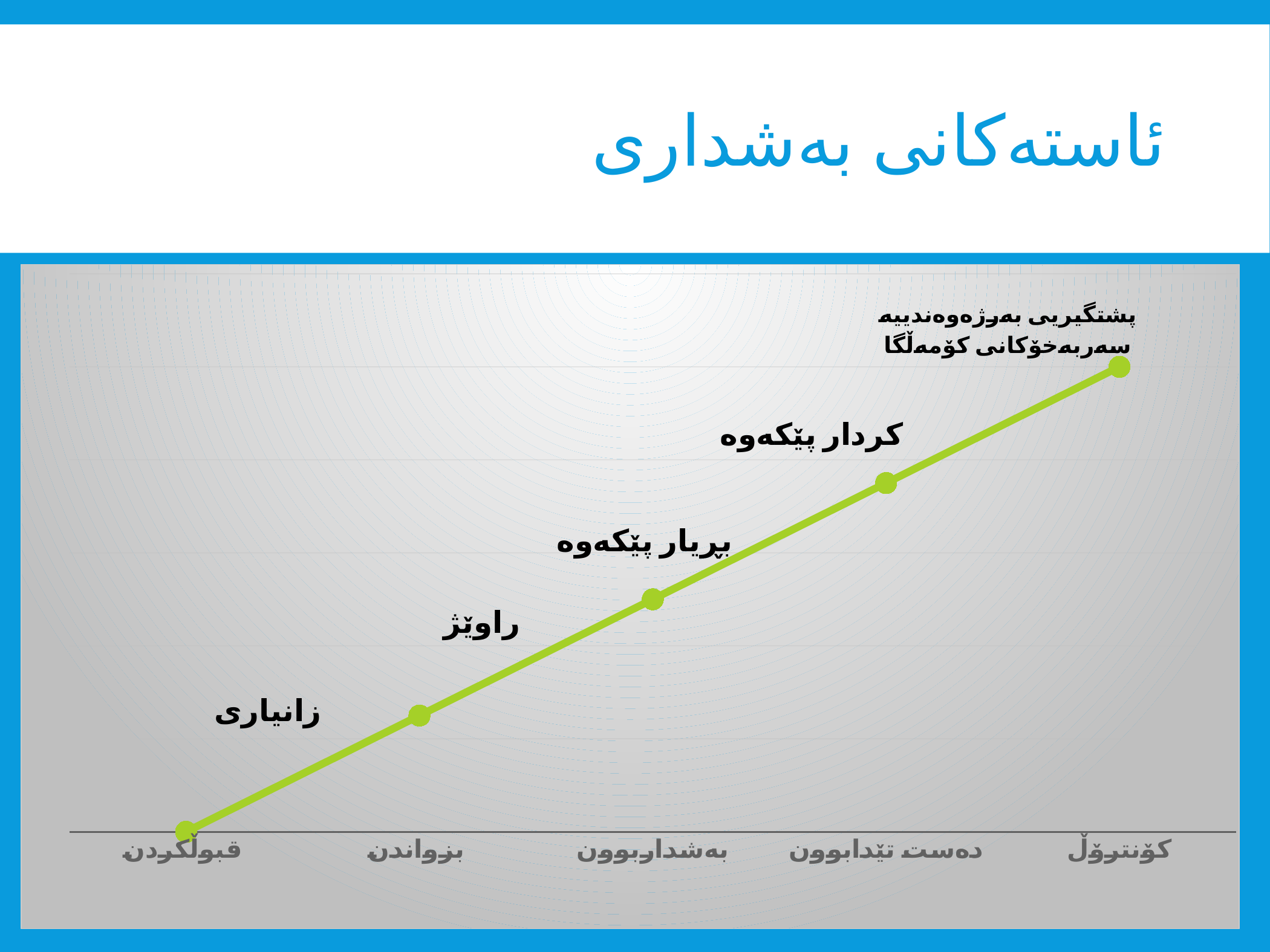
Which is higher on the line, بزواندن or دەست تێدابوون? دەست تێدابوون What colour is the plotted line? green Which category is in the middle of the x axis? بەشداربوون Which category has the highest point on the line? کۆنترۆڵ How many categories are shown on the x axis? 5 Which is lower on the line, بەشداربوون or قبوڵکردن? قبوڵکردن What is the title of the slide above the chart? ئاستەکانی بەشداری What kind of chart is shown on the slide? line chart Do the values rise or fall from left to right along the x axis? rise Which category has the lowest point on the line? قبوڵکردن How many data points are plotted on the line? 5 Which category is the first (leftmost) on the x axis? قبوڵکردن